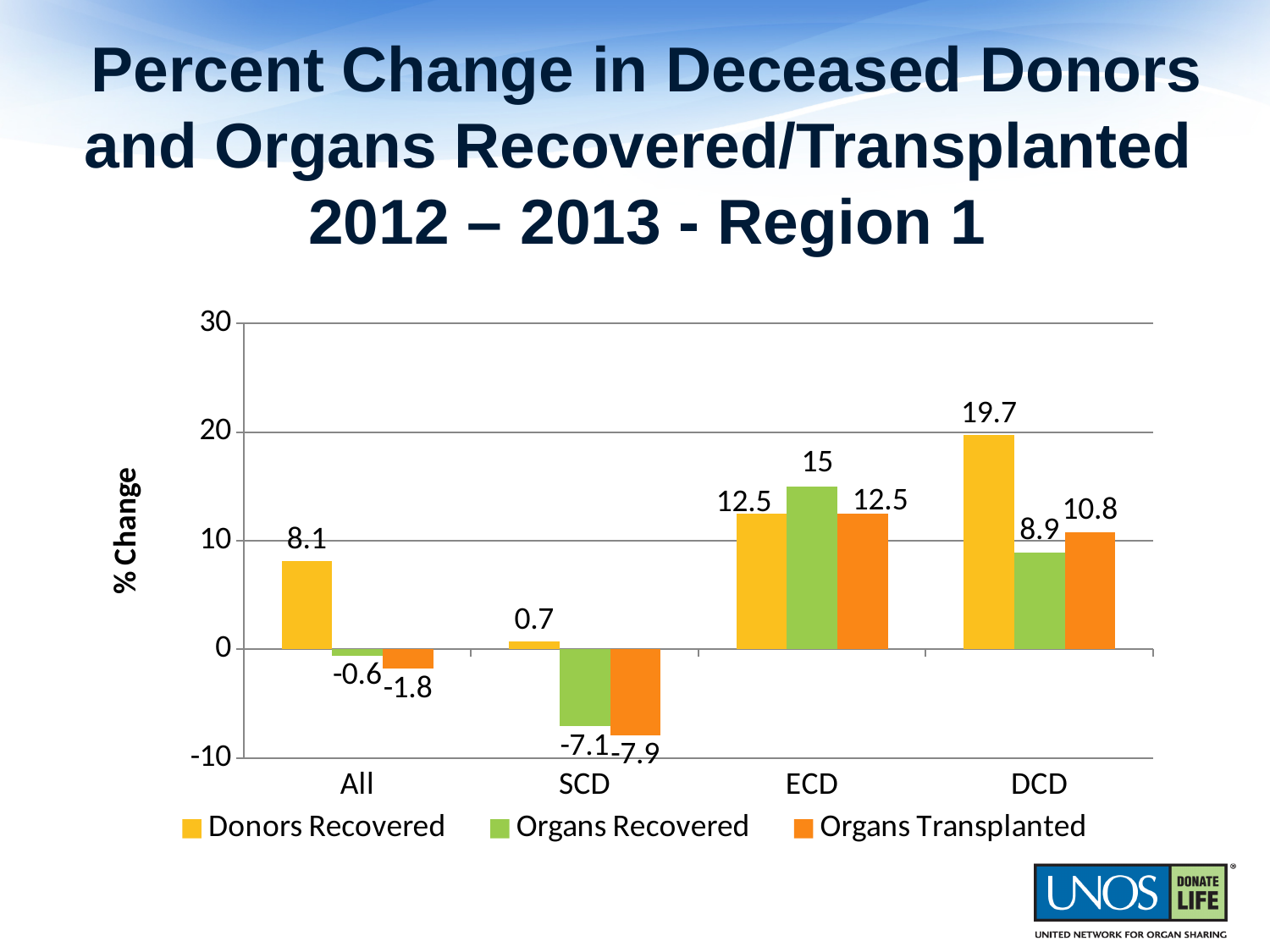
Which category has the highest value for Donors Recovered? DCD What is the value for Organs Transplanted in the All category? -1.8 What is the difference between Donors Recovered and Organs Recovered in the DCD category? 10.8 What is the label of the y axis? % Change How many categories are shown on the x axis? 4 Which is larger in the ECD category: Organs Recovered or Organs Transplanted? Organs Recovered What is the value for Donors Recovered in the DCD category? 19.7 Which category has the lowest value for Organs Transplanted? SCD What kind of chart is shown on the slide? Bar chart Which series is shown in green in the legend? Organs Recovered How many series does the legend list? 3 What is the value for Organs Recovered in the SCD category? -7.1